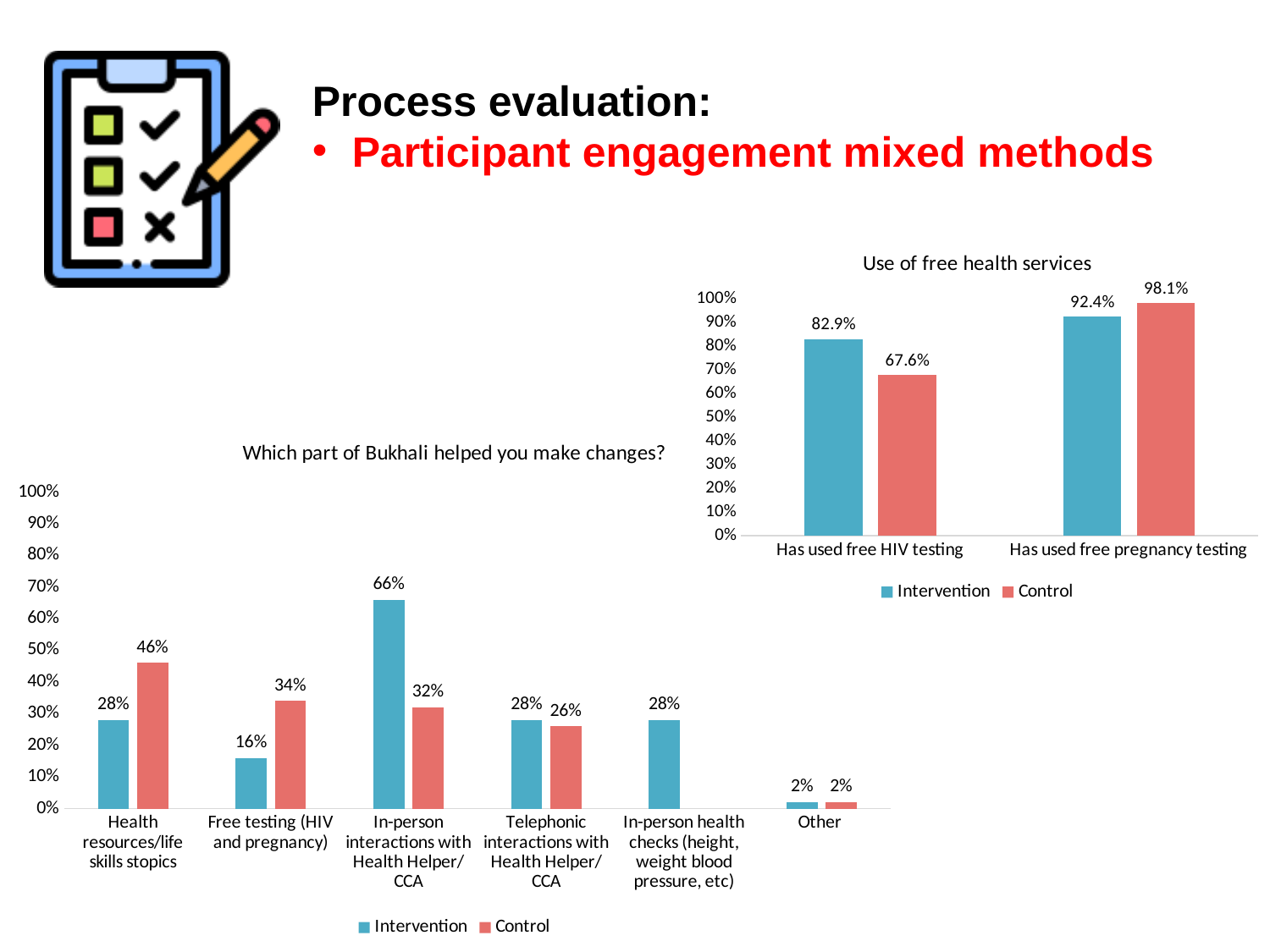
In the 'Which part of Bukhali helped you make changes?' chart, what is the Control value for 'Free testing (HIV and pregnancy)'? 34% What type of chart is the 'Which part of Bukhali helped you make changes?' chart? Bar chart In the 'Which part of Bukhali helped you make changes?' chart, what is the difference between the Control and Intervention values for 'Health resources/life skills topics'? 18% In the 'Use of free health services' chart, what is the Control value for 'Has used free pregnancy testing'? 98.1% In the 'Which part of Bukhali helped you make changes?' chart, how many categories are shown on the x axis? 6 In the 'Which part of Bukhali helped you make changes?' chart, which category has the lowest Control value? Other In the 'Use of free health services' chart, what is the Intervention value for 'Has used free HIV testing'? 82.9% In the 'Which part of Bukhali helped you make changes?' chart, which category has the highest Intervention value? In-person interactions with Health Helper/CCA In the 'Use of free health services' chart, which group has the higher value for 'Has used free pregnancy testing'? Control In the 'Use of free health services' chart, what is the difference between the Intervention and Control values for 'Has used free HIV testing'? 15.3% In the 'Which part of Bukhali helped you make changes?' chart, what is the Intervention value for 'In-person interactions with Health Helper/CCA'? 66% In the 'Use of free health services' chart, how many series does the legend list? 2